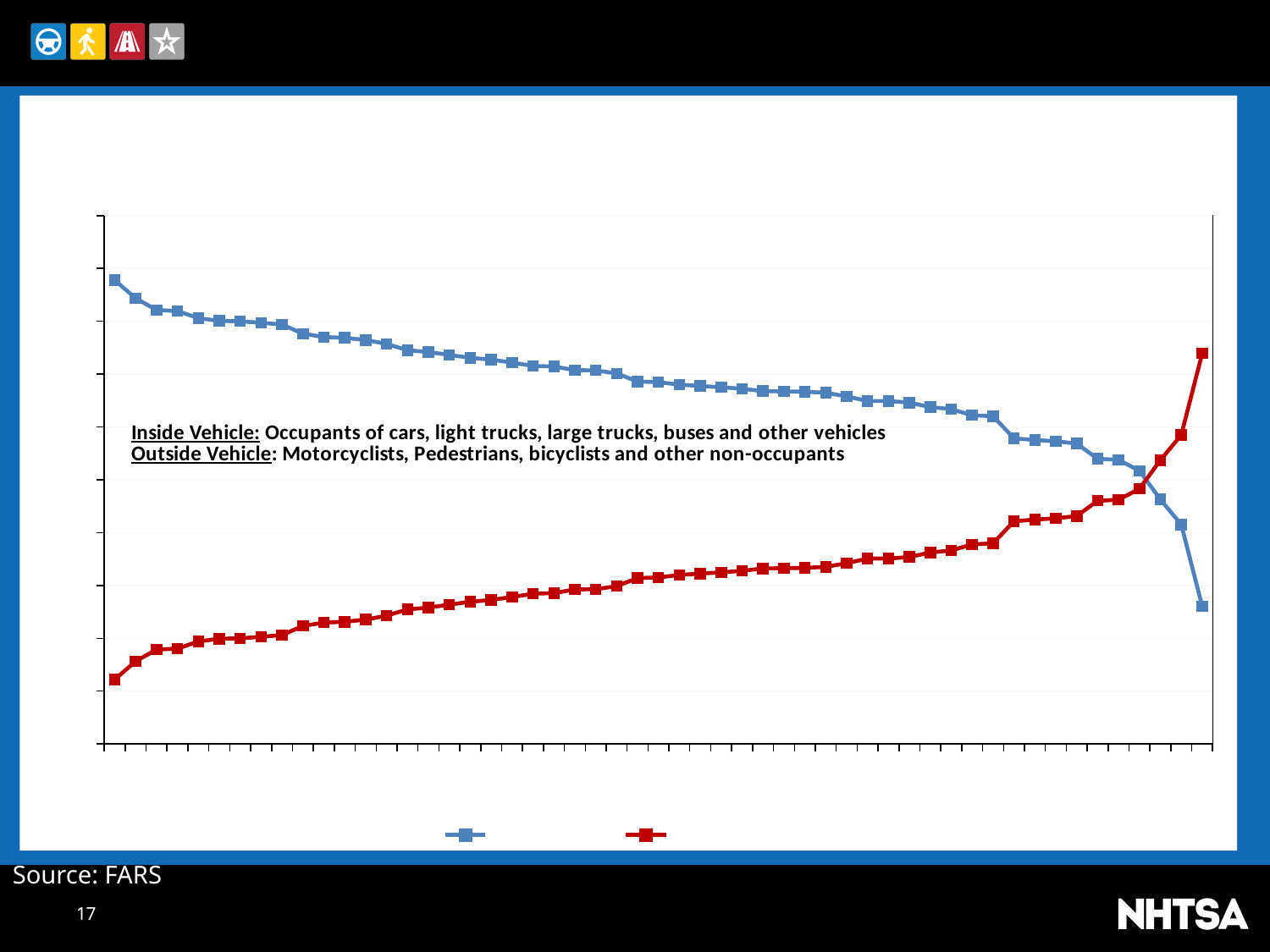
Does the red series rise or fall from left to right along the x axis? rise Which series reaches the highest point on the chart, the blue or the red? blue Does the blue series rise or fall from left to right along the x axis? fall Do the two lines cross each other on the chart? yes Which series reaches the lowest point on the chart, the blue or the red? red At the left end of the chart, which series has the higher value, the blue or the red? blue What kind of chart is shown on the slide? line chart What two colours are used for the series on the chart? blue and red How many series are plotted on the chart? 2 At the right end of the chart, which series has the higher value, the blue or the red? red